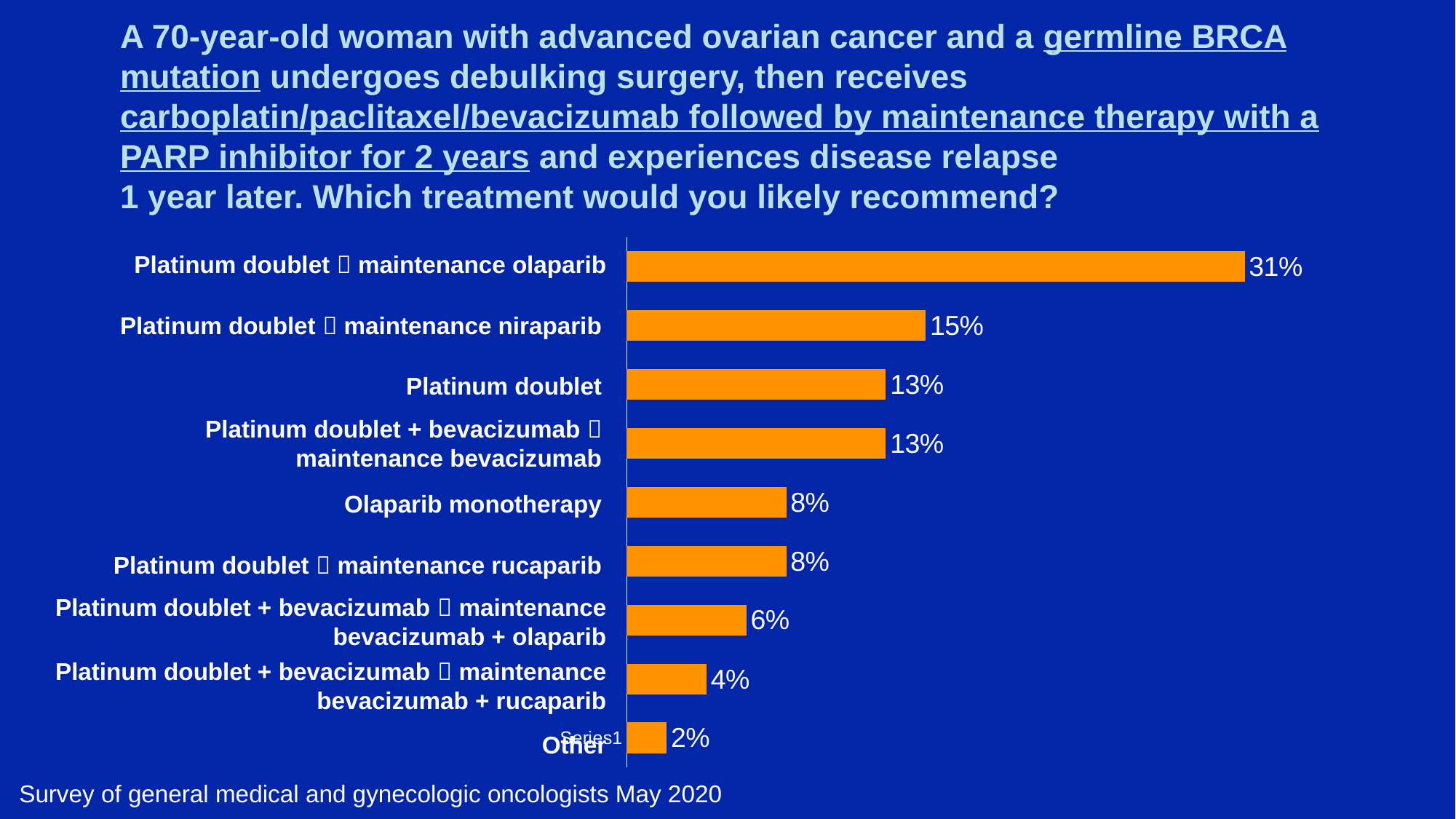
What value is shown for Olaparib monotherapy? 8% What percentage of respondents chose platinum doublet followed by maintenance olaparib? 31% What percentage is shown for the 'Other' category? 2% What type of chart is shown on the slide? Bar chart What value is shown for platinum doublet + bevacizumab followed by maintenance bevacizumab + olaparib? 6% Which category has the lowest value on the chart? Other Which is larger: the value for platinum doublet followed by maintenance rucaparib or the value for platinum doublet + bevacizumab followed by maintenance bevacizumab + rucaparib? Platinum doublet → maintenance rucaparib What percentage of respondents chose platinum doublet followed by maintenance niraparib? 15% What colour are the bars on the chart? Orange Which treatment option received the highest percentage of responses? Platinum doublet → maintenance olaparib How many treatment categories are shown on the chart? 9 What is the difference between the percentage for platinum doublet followed by maintenance olaparib and platinum doublet followed by maintenance niraparib? 16 percentage points